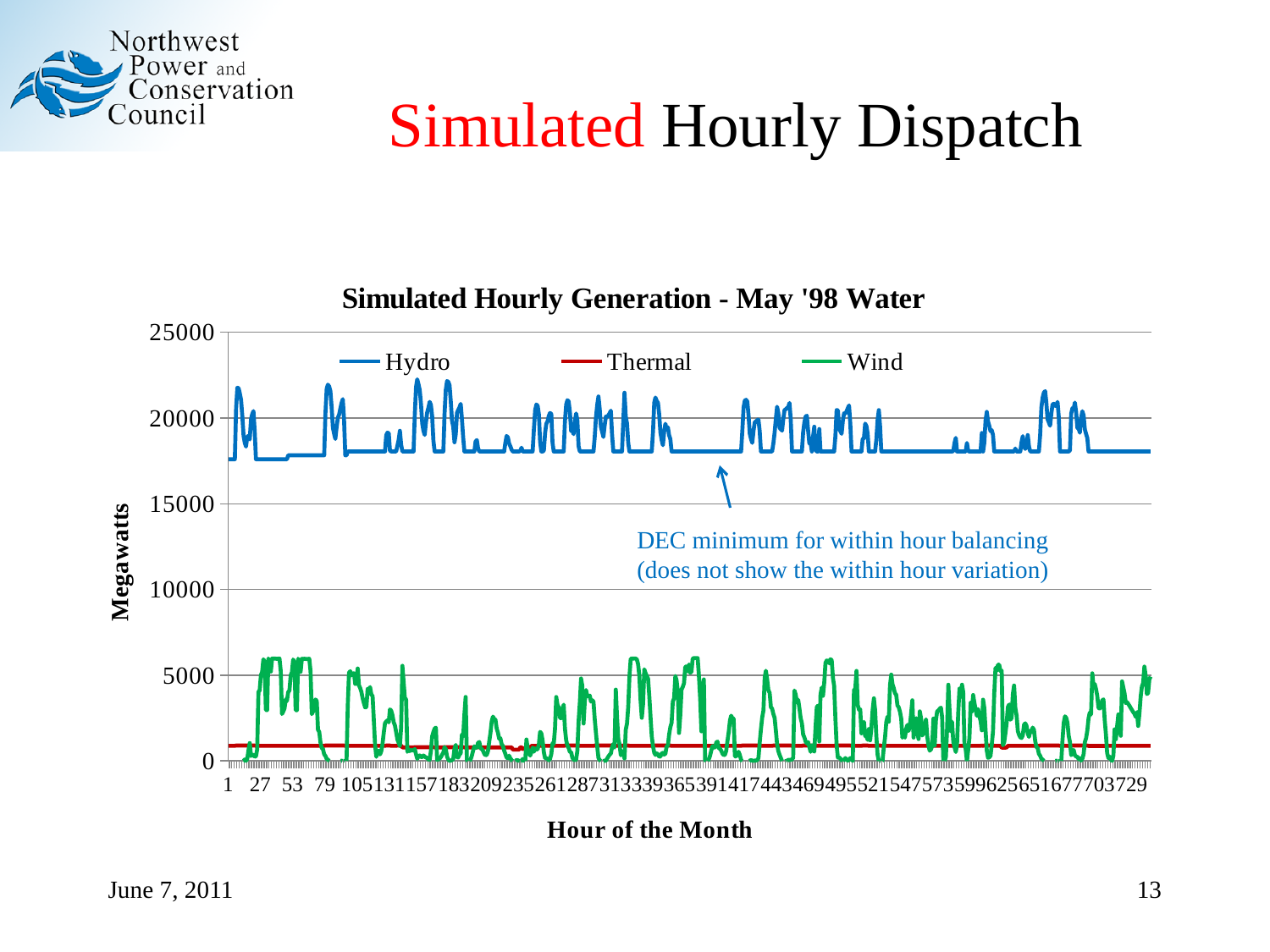
Which series is larger across the month, Wind or Thermal? Wind Which series has the highest values throughout the chart? Hydro Is the Thermal series greater or less than 5000 megawatts throughout the month? less What is the label on the vertical axis of the chart? Megawatts What is the title of the chart? Simulated Hourly Generation - May '98 Water Is the Wind series greater or less than 10000 megawatts throughout the month? less How many series does the legend list? 3 Which series is larger across the month, Hydro or Wind? Hydro Is the Hydro series greater or less than 15000 megawatts throughout the month? greater What kind of chart is shown on the slide? Line chart